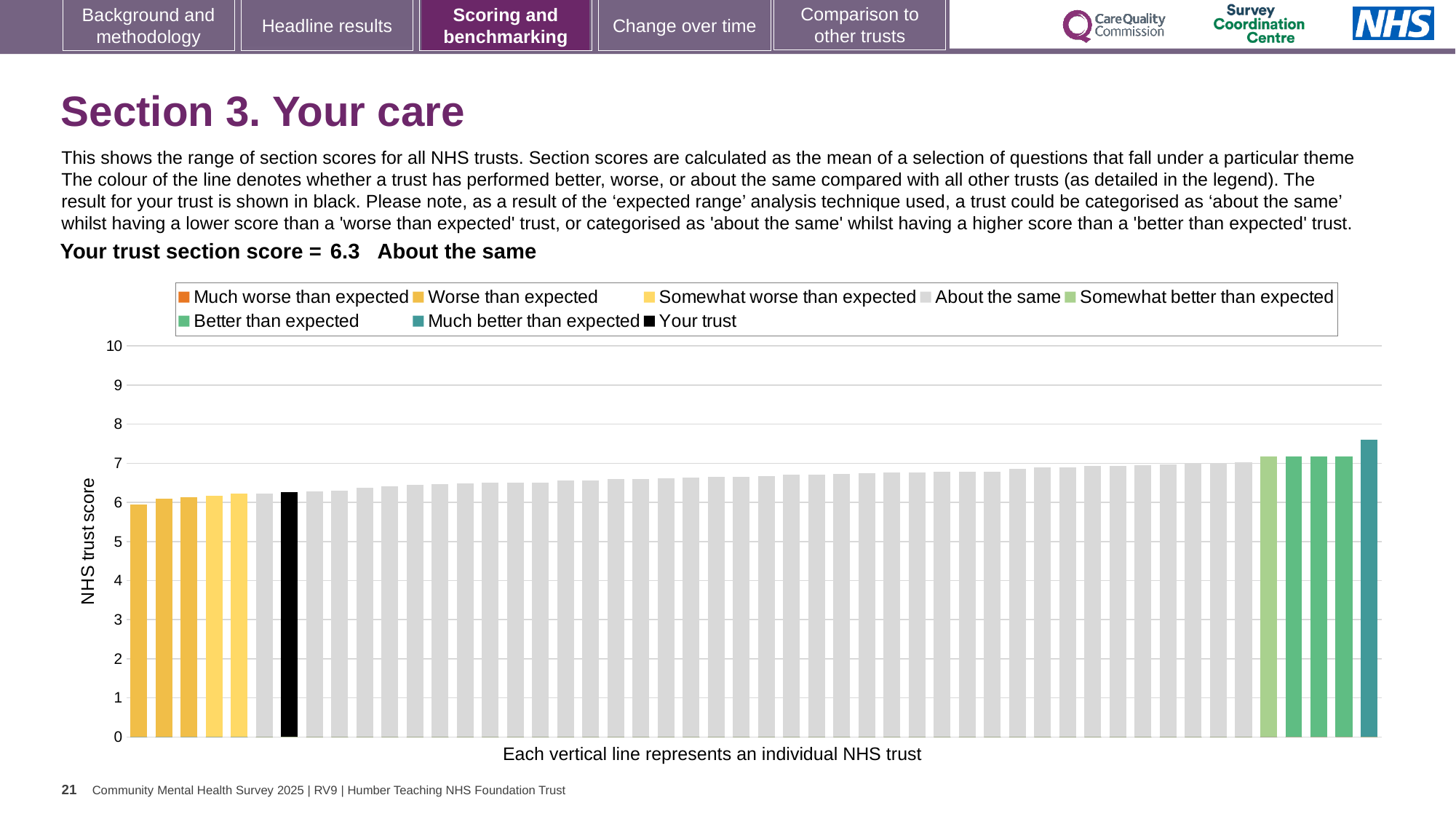
How many entries does the chart legend list? 8 What is the title of the vertical axis? NHS trust score What is the section score for your trust shown on the slide? 6.3 Which is larger: the value of the black 'Your trust' bar or the value of the tallest teal bar on the far right? The tallest teal bar Is the value of the tallest bar greater or less than 7? greater What colour is the bar representing your trust? Black Do the bar values rise or fall from left to right along the x axis? Rise Is the value of the shortest bar greater or less than 7? less Which legend category does the tallest bar belong to? Much better than expected Is the value of the black 'Your trust' bar greater or less than 5? greater What kind of chart is shown on the slide? Bar chart